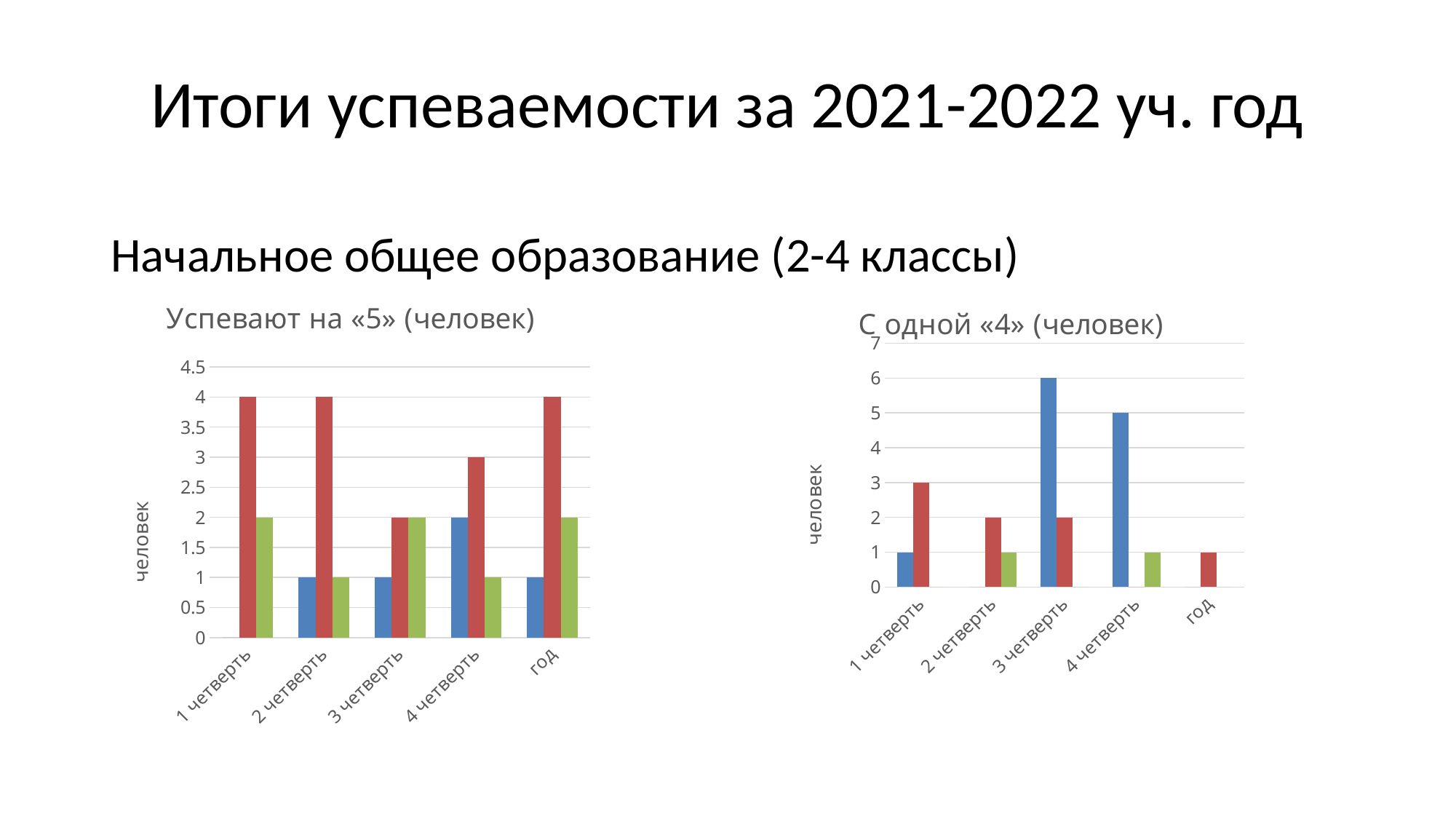
In the chart titled «Успевают на «5» (человек)», which category has the lowest red bar? 3 четверть In the chart titled «Успевают на «5» (человек)», what is the difference between the red bar and the green bar for год? 2 In the chart titled «С одной «4» (человек)», what is the value of the red bar for 1 четверть? 3 In the chart titled «Успевают на «5» (человек)», what is the value of the blue bar for 4 четверть? 2 In the chart titled «Успевают на «5» (человек)», how many categories are shown on the x axis? 5 In the chart titled «Успевают на «5» (человек)», what is the value of the green bar for 3 четверть? 2 In the chart titled «С одной «4» (человек)», which is larger for 4 четверть: the blue bar or the green bar? the blue bar In the chart titled «С одной «4» (человек)», what is the value of the blue bar for 3 четверть? 6 In the chart titled «С одной «4» (человек)», which category has the highest blue bar? 3 четверть What is the label of the vertical axis on the chart titled «Успевают на «5» (человек)»? человек What type of chart is the chart titled «С одной «4» (человек)»? bar chart In the chart titled «Успевают на «5» (человек)», what is the value of the red bar for 1 четверть? 4